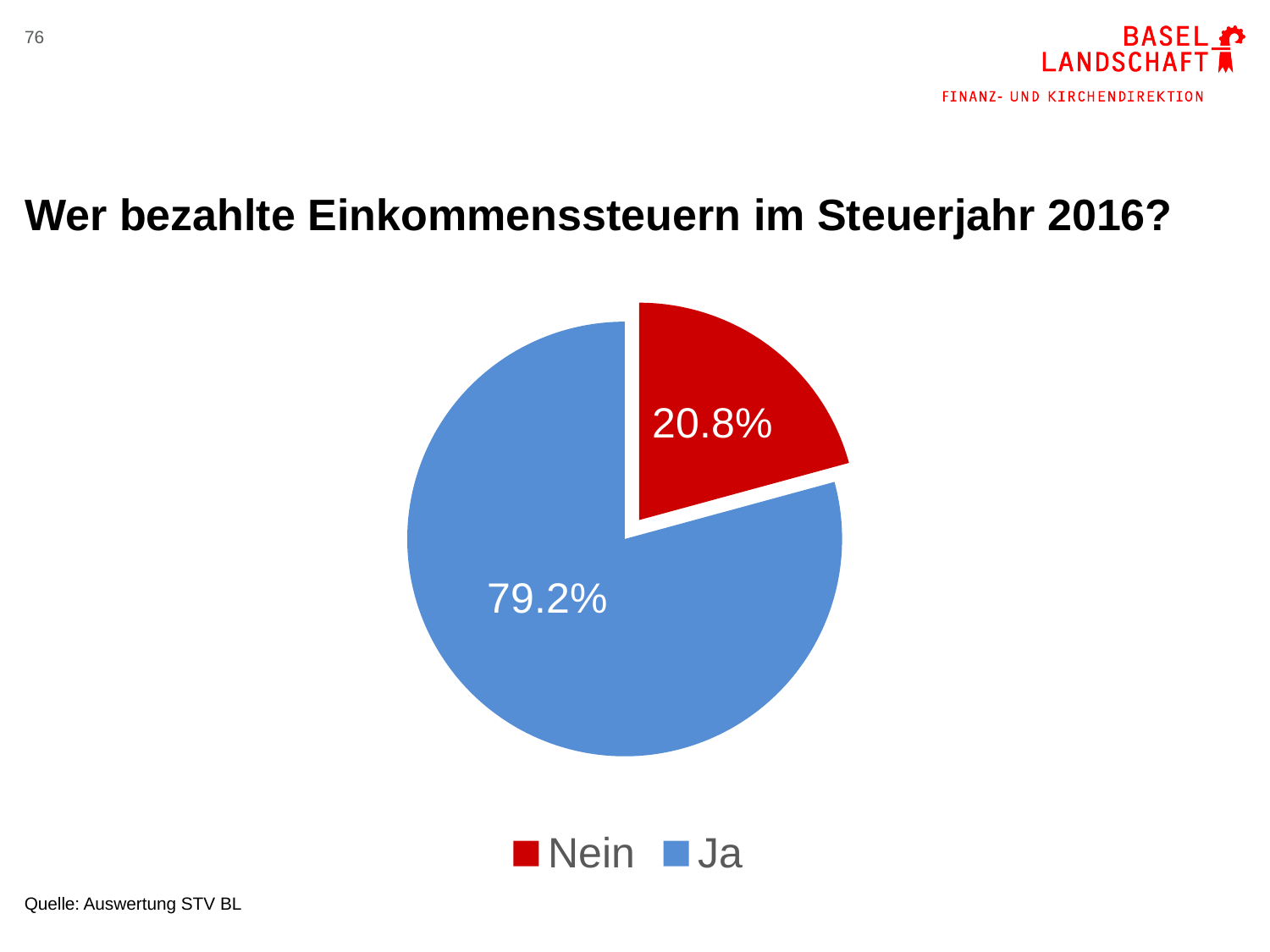
What type of chart is shown on the slide? pie chart What colour is the 'Ja' slice? blue What colour is the 'Nein' slice? red What is the difference in percentage points between the 'Ja' and 'Nein' slices? 58.4 Which is larger, the 'Ja' slice or the 'Nein' slice? Ja How many entries does the legend list? 2 What share of the pie does the 'Ja' slice represent? 79.2% How many slices does the pie chart have? 2 What is the total of the two slices shown in the pie chart? 100% Which slice is the smallest in the pie chart? Nein Which slice is the largest in the pie chart? Ja What share of the pie does the 'Nein' slice represent? 20.8%